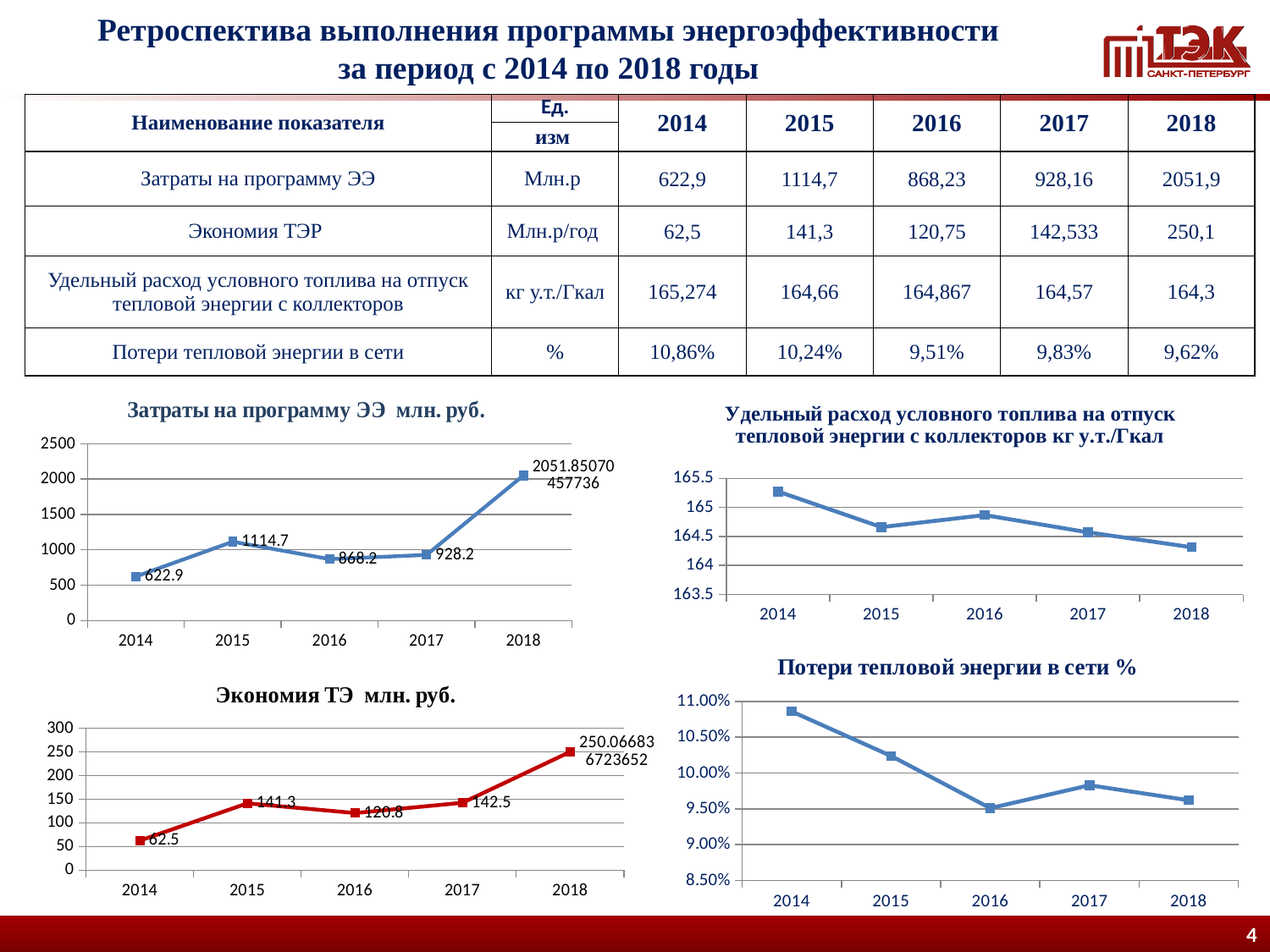
In the chart titled 'Экономия ТЭ млн. руб.', how many years are plotted? 5 In the chart titled 'Удельный расход условного топлива на отпуск тепловой энергии с коллекторов кг у.т./Гкал', is the value for 2014 greater or less than 165? greater In the chart titled 'Потери тепловой энергии в сети %', is the value for 2016 greater or less than 10.00%? less In the chart titled 'Экономия ТЭ млн. руб.', which year has the lowest value? 2014 What kind of chart is the chart titled 'Потери тепловой энергии в сети %'? line chart In the chart titled 'Экономия ТЭ млн. руб.', what is the value for 2016? 120.8 In the chart titled 'Затраты на программу ЭЭ млн. руб.', what is the value for 2015? 1114.7 In the chart titled 'Затраты на программу ЭЭ млн. руб.', what is the difference between the values for 2017 and 2016? 60 In the chart titled 'Затраты на программу ЭЭ млн. руб.', which year has the highest value? 2018 In the chart titled 'Затраты на программу ЭЭ млн. руб.', what is the value for 2014? 622.9 In the chart titled 'Удельный расход условного топлива на отпуск тепловой энергии с коллекторов кг у.т./Гкал', which year has the lowest value? 2018 In the chart titled 'Экономия ТЭ млн. руб.', which is larger, the value for 2015 or the value for 2017? 2017